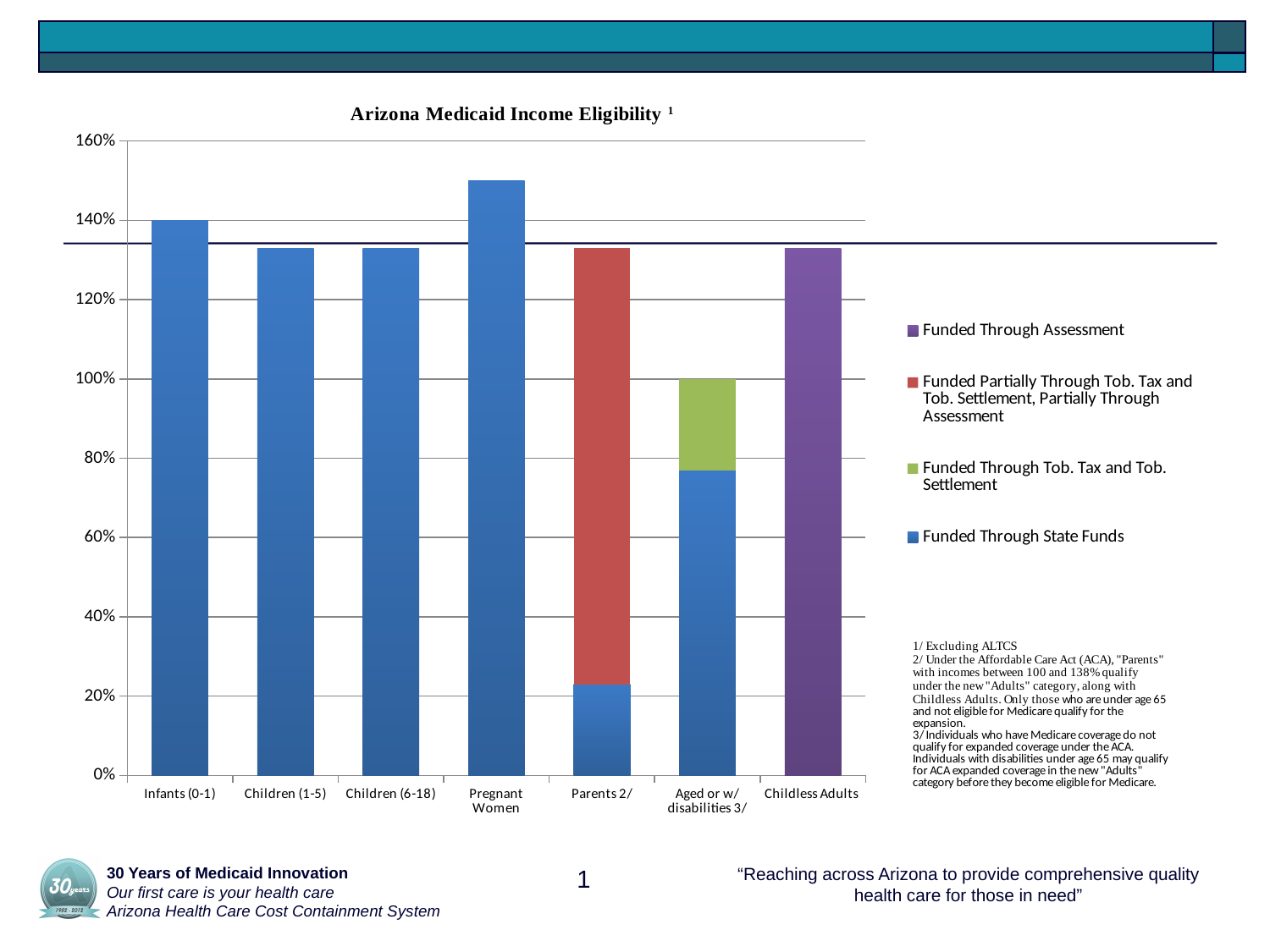
What is the title of the chart? Arizona Medicaid Income Eligibility Which category has the highest bar? Pregnant Women How many categories are shown on the x axis of the chart? 7 Is the value for Pregnant Women greater or less than 140%? greater Which category has the lowest total bar height? Aged or w/ disabilities 3/ How many series does the legend list? 4 Which series does the Childless Adults bar belong to, according to the legend? Funded Through Assessment Is the value for Children (1-5) greater or less than 140%? less Is the Funded Through State Funds portion of the Parents 2/ bar greater or less than 40%? less Which is larger, the value for Infants (0-1) or the value for Children (6-18)? Infants (0-1) What kind of chart is shown on the slide? Bar chart